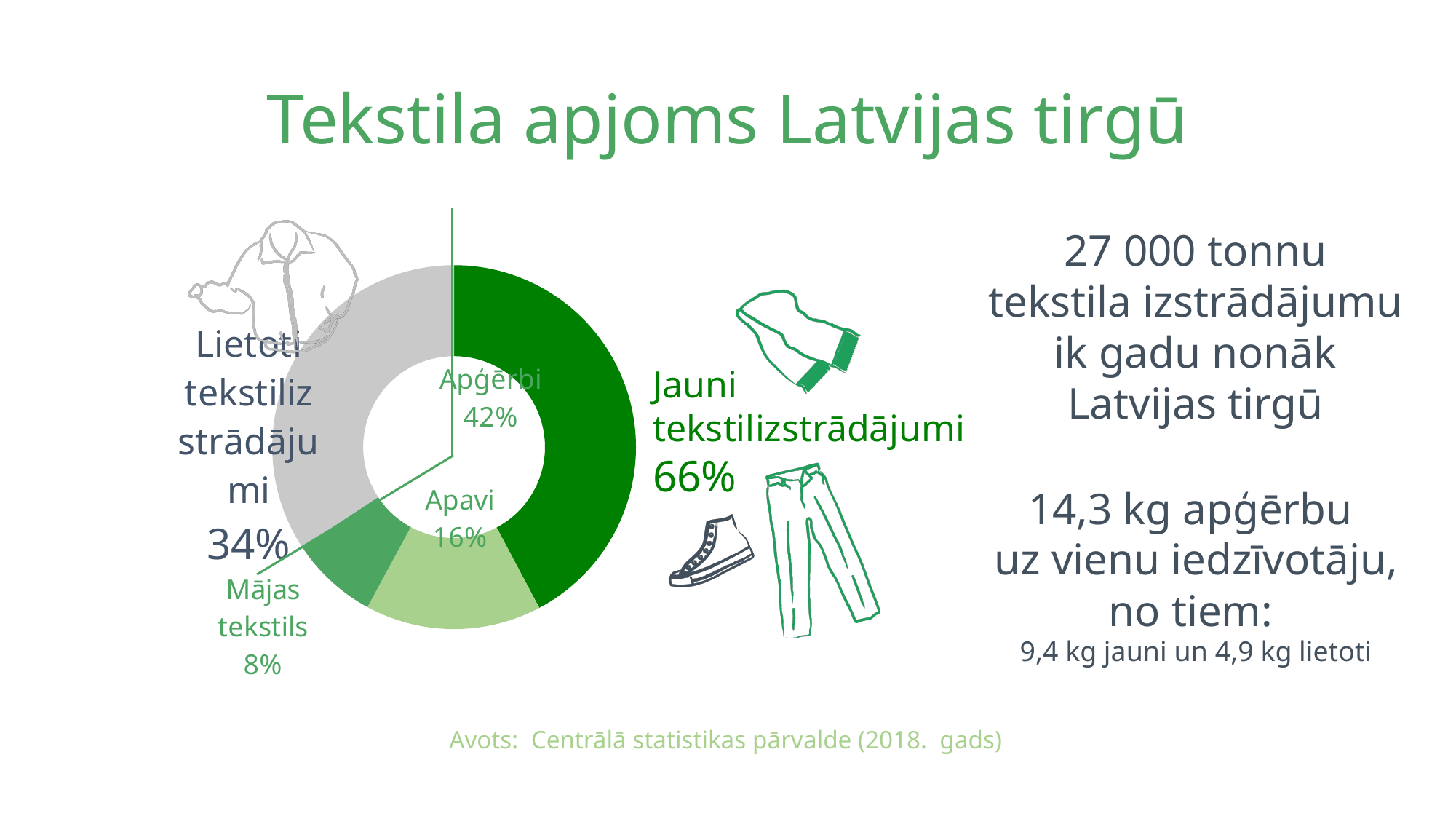
What share of the chart is Apģērbi? 42% What combined share do the Jauni tekstilizstrādājumi slices (Apģērbi, Apavi, Mājas tekstils) make up? 66% What share of the chart is Apavi? 16% What kind of chart is shown on the slide? Donut (pie) chart Which is larger, Lietoti tekstilizstrādājumi or Apavi? Lietoti tekstilizstrādājumi Which slice of the chart is the largest? Apģērbi What share of the chart is Mājas tekstils? 8% What share of the chart is Lietoti tekstilizstrādājumi? 34% How many slices does the chart have? 4 What is the difference in percentage points between Apģērbi and Apavi? 26 Which slice of the chart is the smallest? Mājas tekstils What is the title of the slide containing the chart? Tekstila apjoms Latvijas tirgū